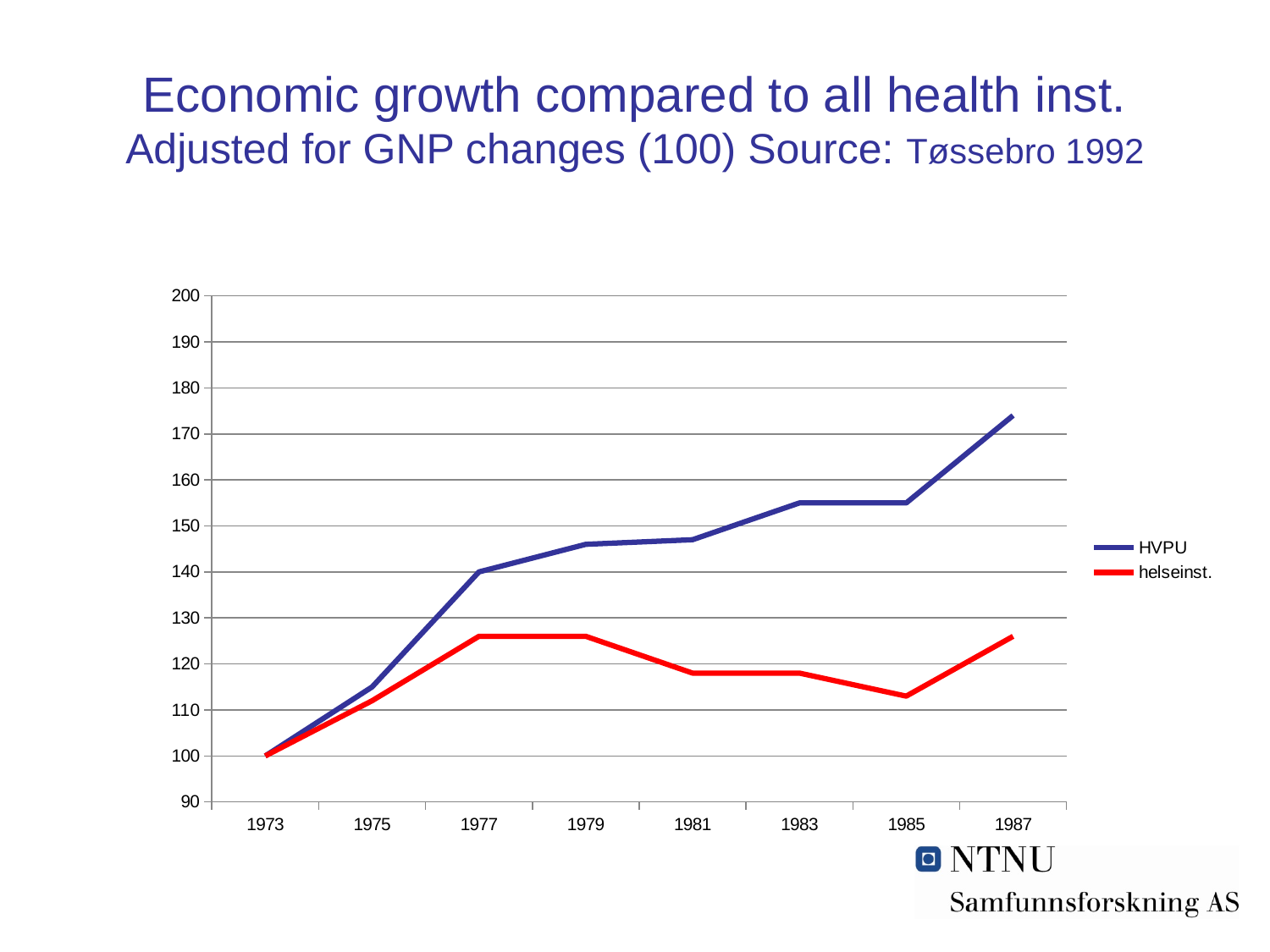
In 1987, which series has the higher value, HVPU or helseinst.? HVPU What kind of chart is shown on the slide? line chart How many years are plotted along the x axis? 8 How many series does the legend list? 2 Does the HVPU series generally rise or fall from 1973 to 1987? rise In which year does the HVPU series reach its highest value? 1987 What is the value for helseinst. in 1973? 100 Is the value for HVPU in 1983 greater or less than 150? greater Is the value for HVPU in 1987 greater or less than 170? greater Is the value for helseinst. in 1985 greater or less than 120? less What is the value for HVPU in 1973? 100